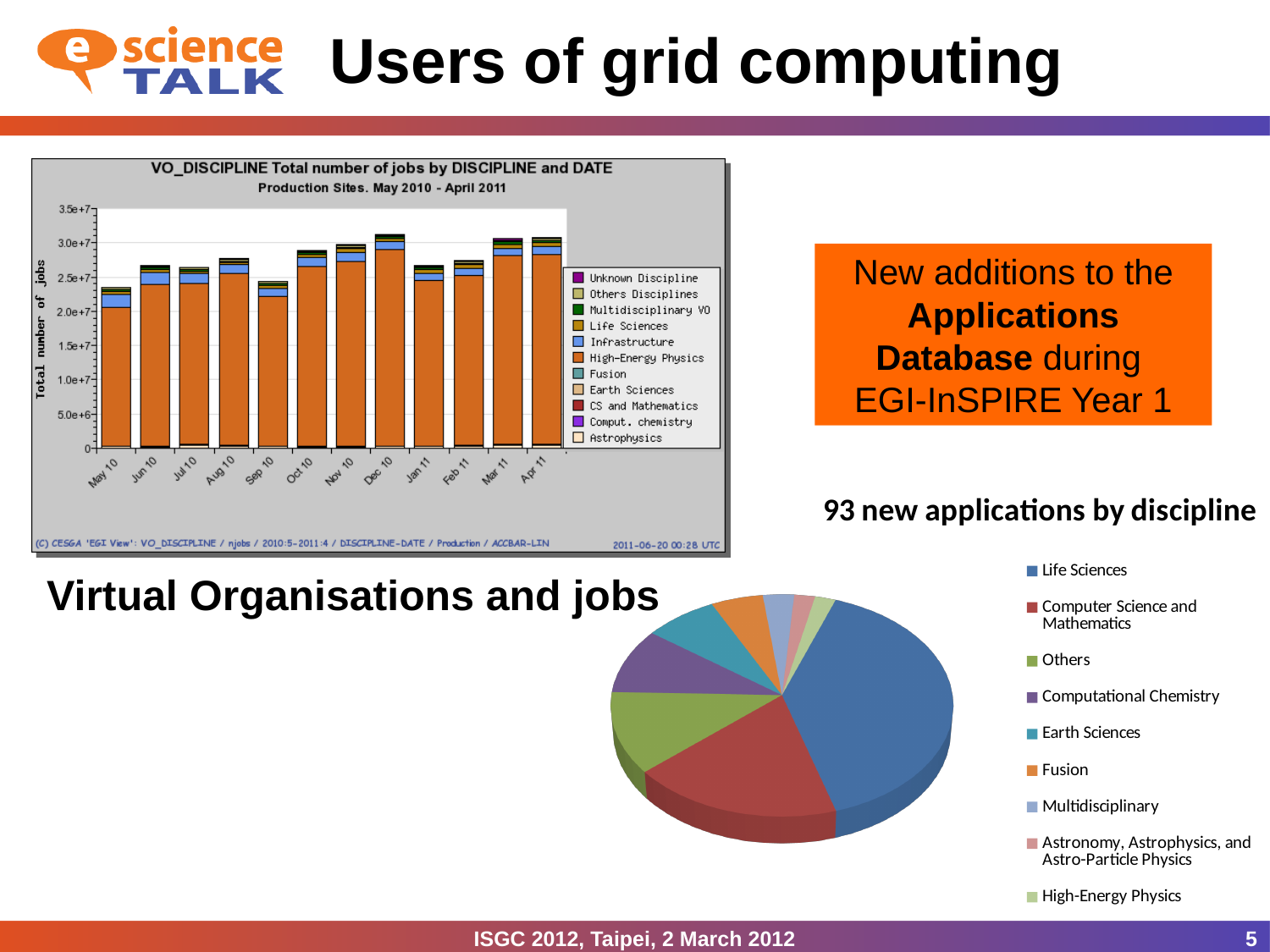
In the bar chart on the left, which month has the lowest total number of jobs? May 10 What kind of chart is the chart labelled '93 new applications by discipline'? pie chart In the pie chart '93 new applications by discipline', which discipline has the largest slice? Life Sciences In the bar chart on the left, which month has the highest total number of jobs? Dec 10 In the pie chart '93 new applications by discipline', how many disciplines does the legend list? 9 In the bar chart on the left, is the total number of jobs for Jun 10 greater or less than 2.5e+7? greater In the bar chart on the left, is the total number of jobs for May 10 greater or less than 2.5e+7? less In the bar chart on the left, how many disciplines does the legend list? 11 In the bar chart on the left, which discipline accounts for the largest portion of each bar? High-Energy Physics In the bar chart on the left, which is larger, the total for Dec 10 or the total for Jan 11? Dec 10 What kind of chart is the chart titled 'VO_DISCIPLINE Total number of jobs by DISCIPLINE and DATE'? bar chart In the bar chart on the left, how many months are shown along the x axis? 12